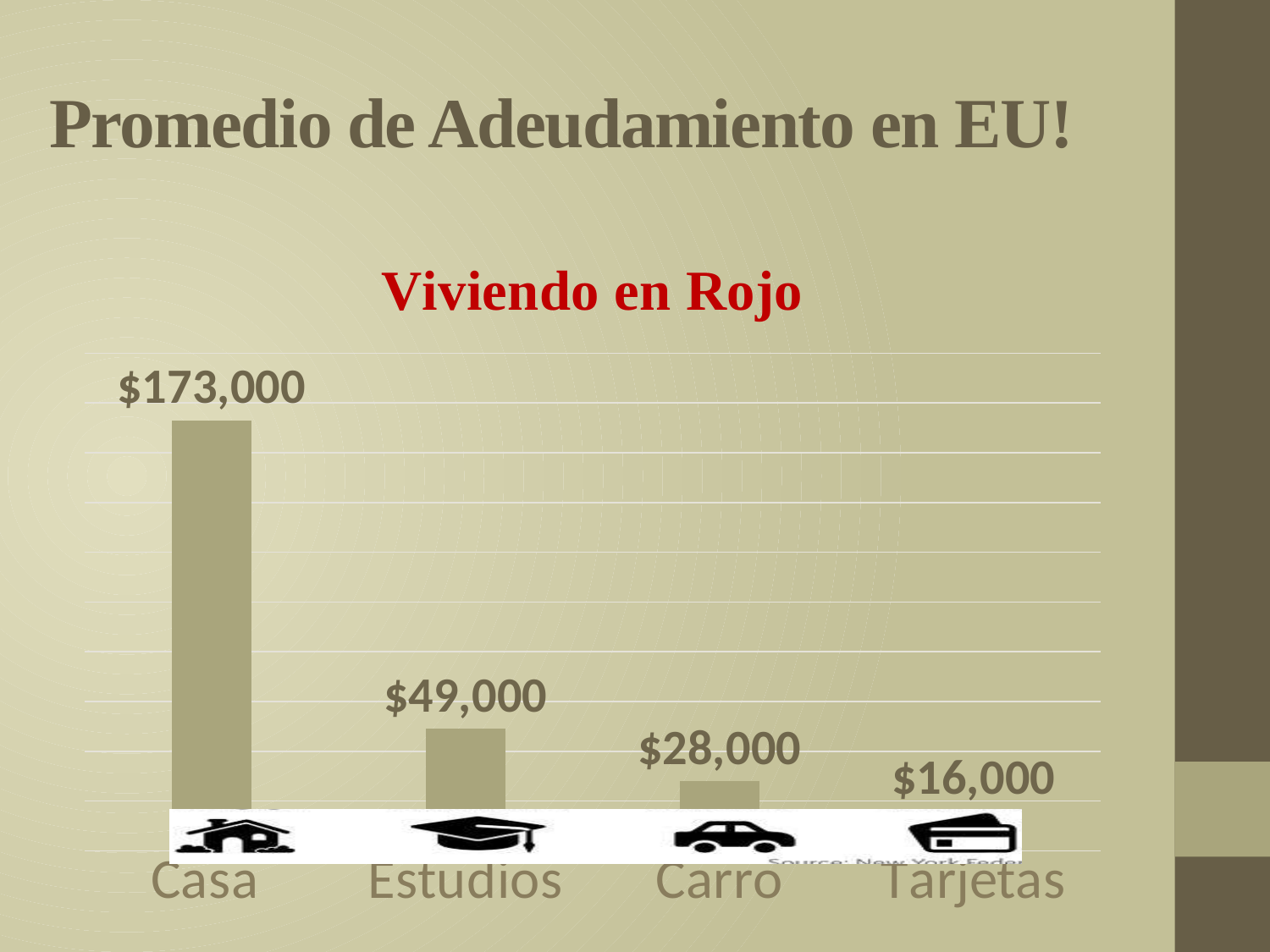
How many categories are shown in the chart? 4 What is the value for Carro? $28,000 What is the value for Tarjetas? $16,000 What is the value for Estudios? $49,000 What is the difference between the values for Casa and Estudios? $124,000 Which category has the lowest value? Tarjetas What is the difference between the values for Carro and Tarjetas? $12,000 What is the value for Casa? $173,000 Do the values rise or fall from left to right along the x axis? Fall Which is larger, the value for Estudios or the value for Carro? Estudios What kind of chart is shown on the slide? Bar chart Which category has the highest value? Casa